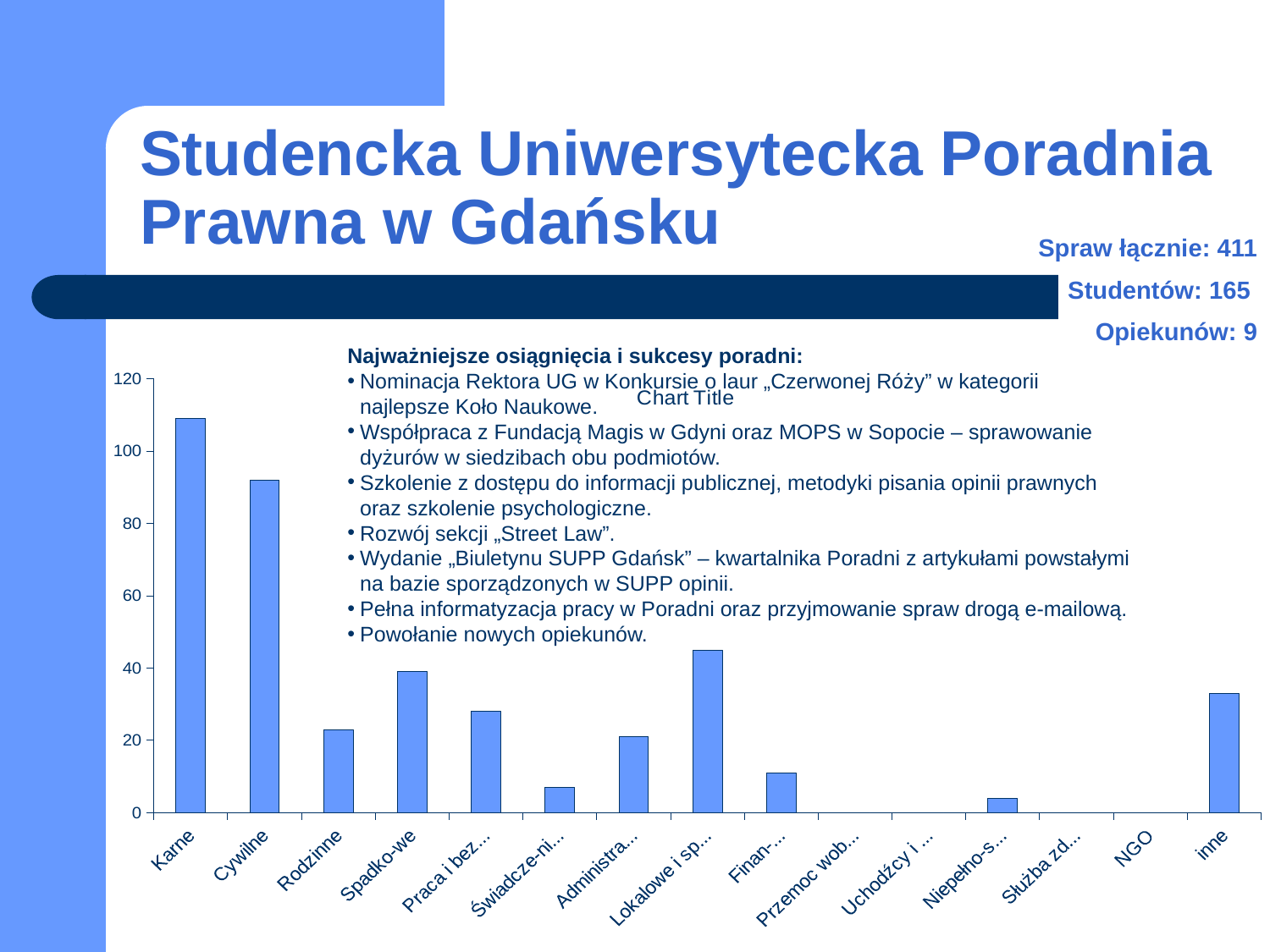
Which is larger, the value for Rodzinne or the value for Spadko-we? Spadko-we Is the value for Świadcze-ni... greater or less than 20? less Which category has the highest bar in the chart? Karne How many categories are shown on the x axis of the chart? 15 Which is larger, the value for Karne or the value for Cywilne? Karne Is the value for Rodzinne greater or less than 40? less What kind of chart is shown on the slide? bar chart Which is larger, the value for NGO or the value for inne? inne Is the value for inne greater or less than 20? greater What is the title shown on the chart? Chart Title